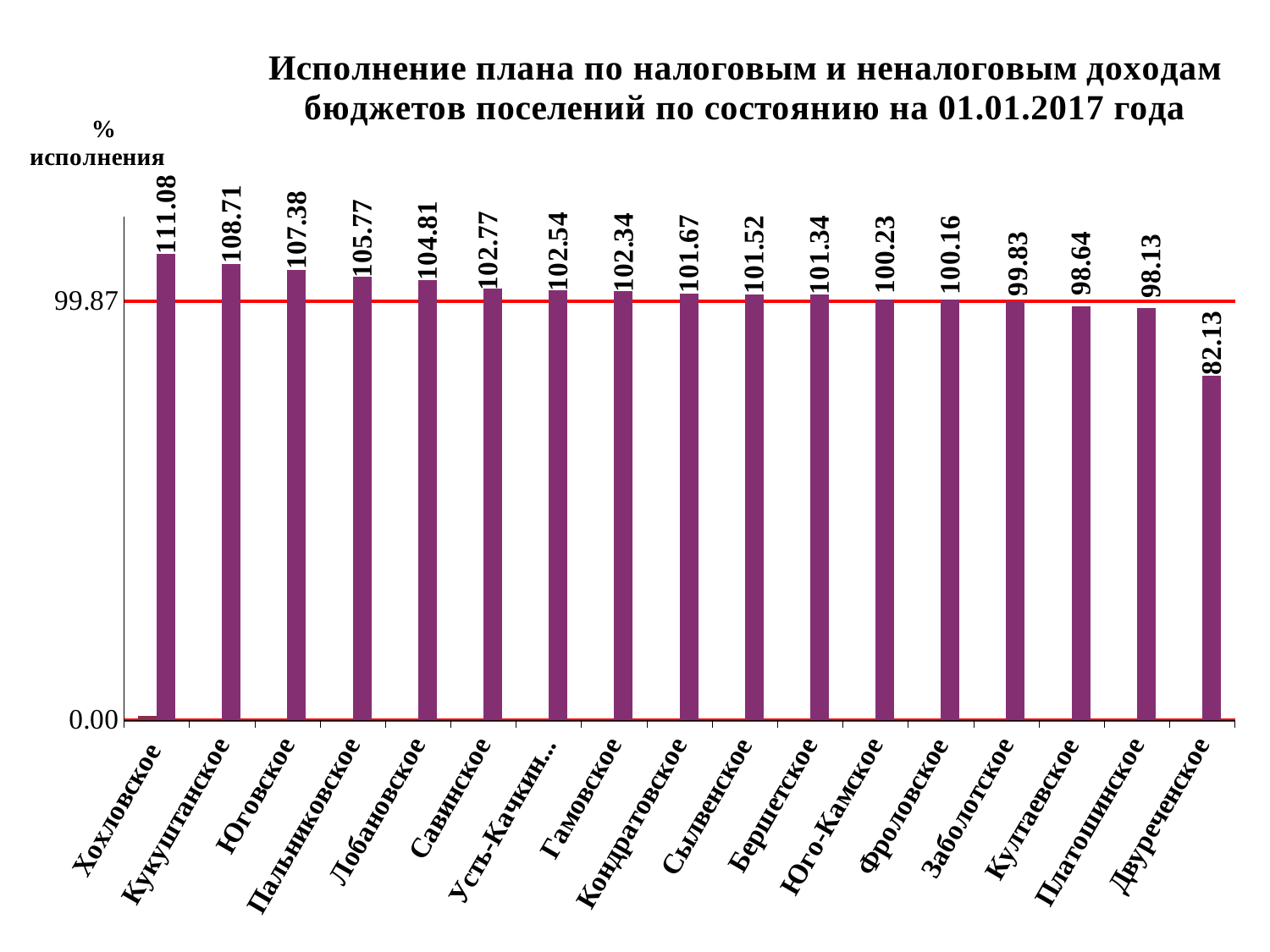
Which category has the highest value? Хохловское What value is marked by the red horizontal line on the y axis? 99.87 What is the value for Двуреченское? 82.13 How many categories are shown on the x axis? 17 What is the value for Заболотское? 99.83 What is the value for Гамовское? 102.34 What is the value for Хохловское? 111.08 Which category has the lowest value? Двуреченское What is the difference between the values for Кукуштанское and Юговское? 1.33 What is the difference between the values for Хохловское and Двуреченское? 28.95 What kind of chart is shown on the slide? Bar chart Which is larger, the value for Лобановское or the value for Савинское? Лобановское